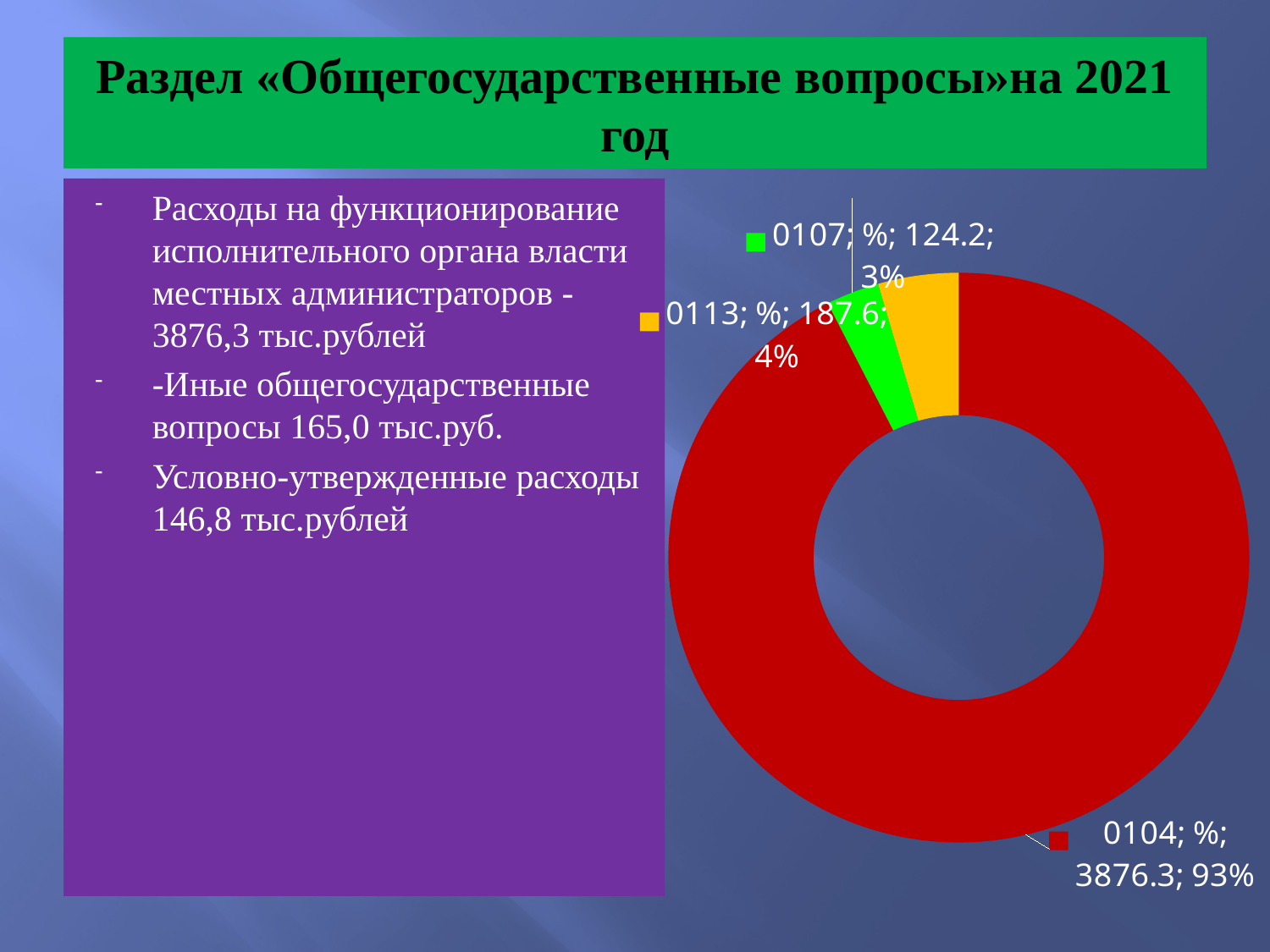
Which category has the largest slice? 0104 Which category has the smallest slice? 0107 What is the value for category 0113? 187.6 What share of the chart does category 0113 represent? 4% What is the value for category 0104? 3876.3 Which is larger, the value for 0113 or the value for 0107? 0113 What colour is the slice for category 0107? green What is the value for category 0107? 124.2 What is the difference between the values for 0113 and 0107? 63.4 What share of the chart does category 0104 represent? 93% How many slices does the chart have? 3 What kind of chart is shown on the slide? doughnut chart